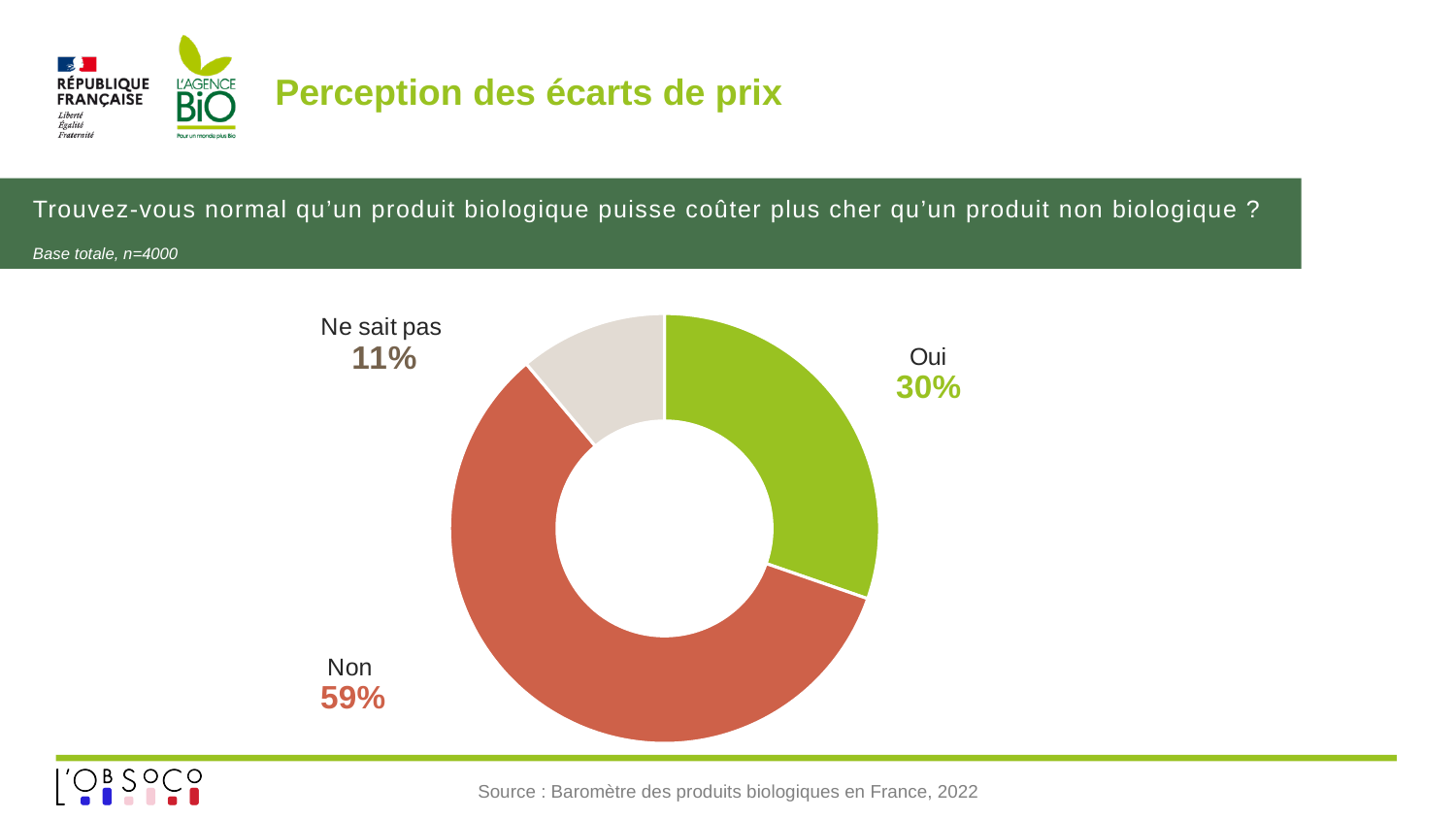
What percentage of respondents answered "Oui"? 30% What is the sample size stated for the chart? n=4000 What is the difference in percentage points between "Oui" and "Ne sait pas"? 19 What kind of chart is shown on the slide? Pie chart (donut) What is the difference in percentage points between "Non" and "Oui"? 29 Which is larger, the share for "Oui" or the share for "Non"? Non Which response has the largest share of the chart? Non What percentage of respondents answered "Non"? 59% What percentage of respondents answered "Ne sait pas"? 11% Which response has the smallest share of the chart? Ne sait pas How many response categories are shown in the chart? 3 What colour is the "Oui" slice of the chart? Green